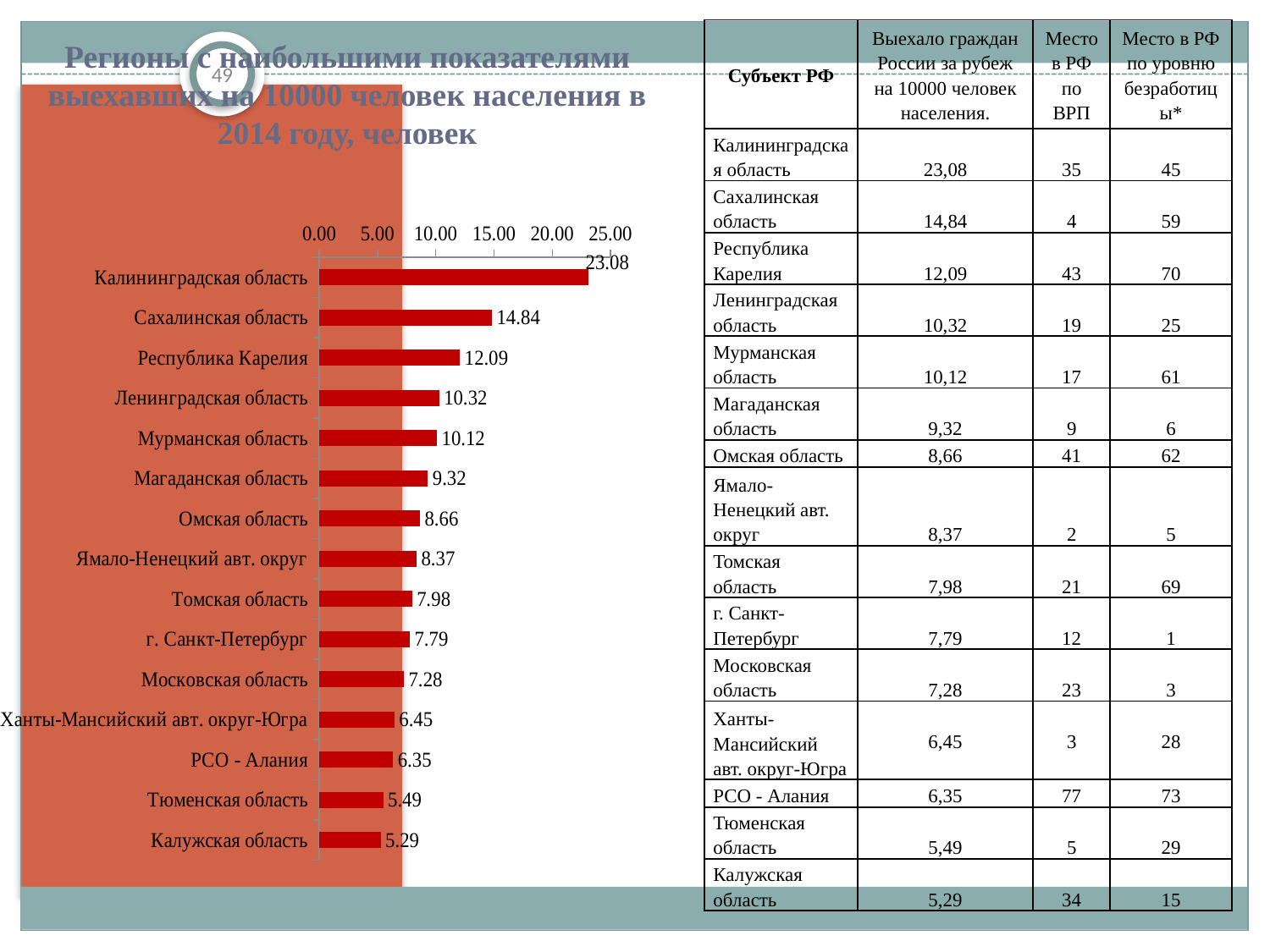
Do the bar values increase or decrease going from the top of the chart to the bottom? decrease Is the value for Калининградская область greater or less than 20.00? greater What is the maximum value shown on the chart's horizontal axis? 25.00 Which region has the lowest value in the chart? Калужская область What is the value shown for Ханты-Мансийский авт. округ-Югра in the chart? 6.45 What is the value shown for Калининградская область in the chart? 23.08 What is the difference between the values for Калининградская область and Сахалинская область? 8.24 Which region has the highest value in the chart? Калининградская область Which has a larger value, Ленинградская область or Мурманская область? Ленинградская область How many regions are plotted in the bar chart? 15 What type of chart is shown on the slide? bar chart What is the value shown for Республика Карелия in the chart? 12.09